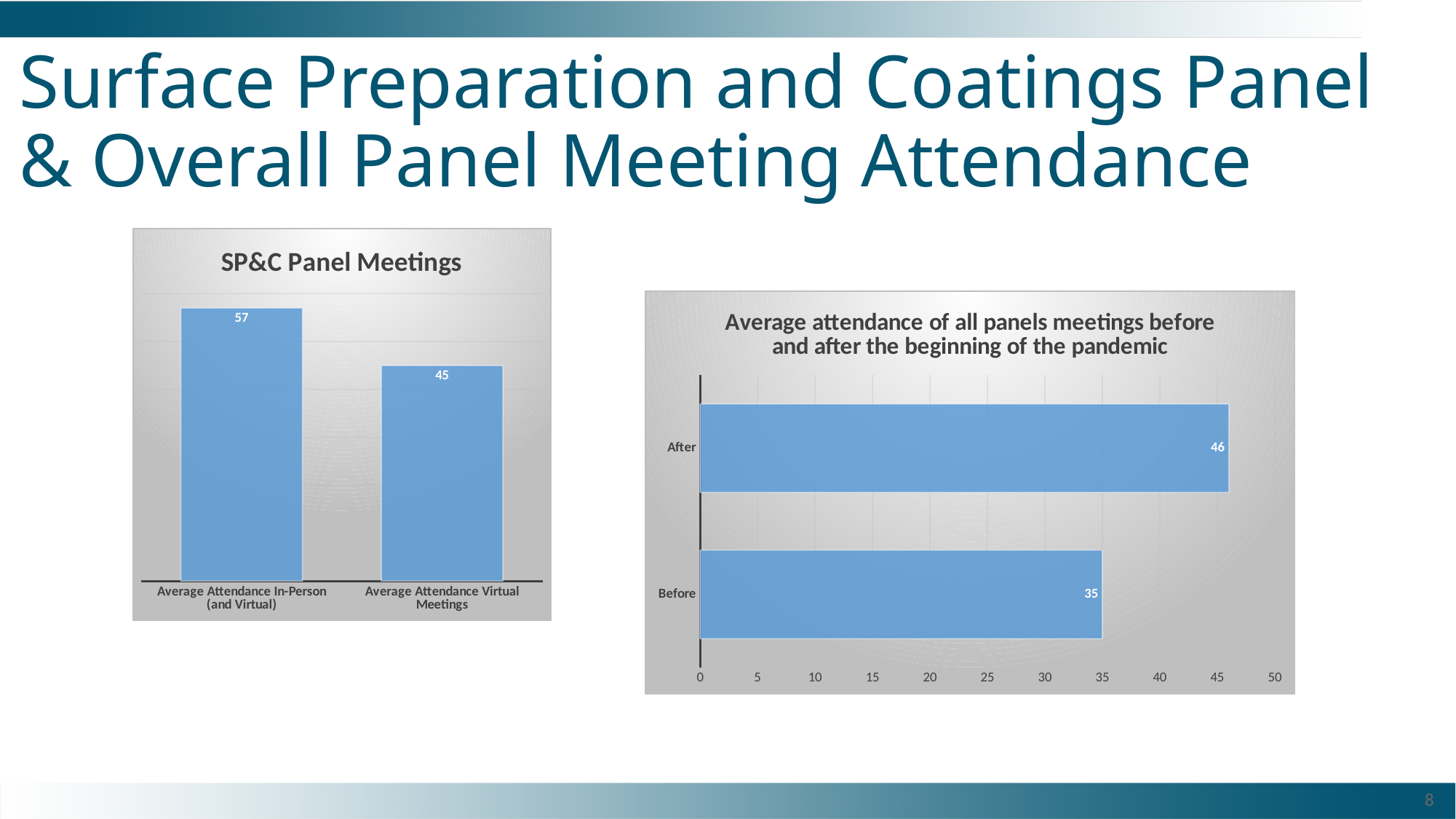
What is the title of the chart on the left of the slide? SP&C Panel Meetings In the 'SP&C Panel Meetings' chart, which category has the highest value? Average Attendance In-Person (and Virtual) In the 'SP&C Panel Meetings' chart, what is the value for Average Attendance In-Person (and Virtual)? 57 In the 'SP&C Panel Meetings' chart, what is the value for Average Attendance Virtual Meetings? 45 In the 'Average attendance of all panels meetings before and after the beginning of the pandemic' chart, what is the value for After? 46 In the 'SP&C Panel Meetings' chart, what is the difference between the In-Person (and Virtual) value and the Virtual Meetings value? 12 In the 'Average attendance of all panels meetings before and after the beginning of the pandemic' chart, which category has the lowest value? Before In the 'Average attendance of all panels meetings before and after the beginning of the pandemic' chart, is the value for After greater or less than 40? greater In the 'Average attendance of all panels meetings before and after the beginning of the pandemic' chart, what is the difference between the After and Before values? 11 What kind of chart is the 'SP&C Panel Meetings' chart? Bar chart In the 'SP&C Panel Meetings' chart, how many categories are shown? 2 In the 'Average attendance of all panels meetings before and after the beginning of the pandemic' chart, what is the value for Before? 35